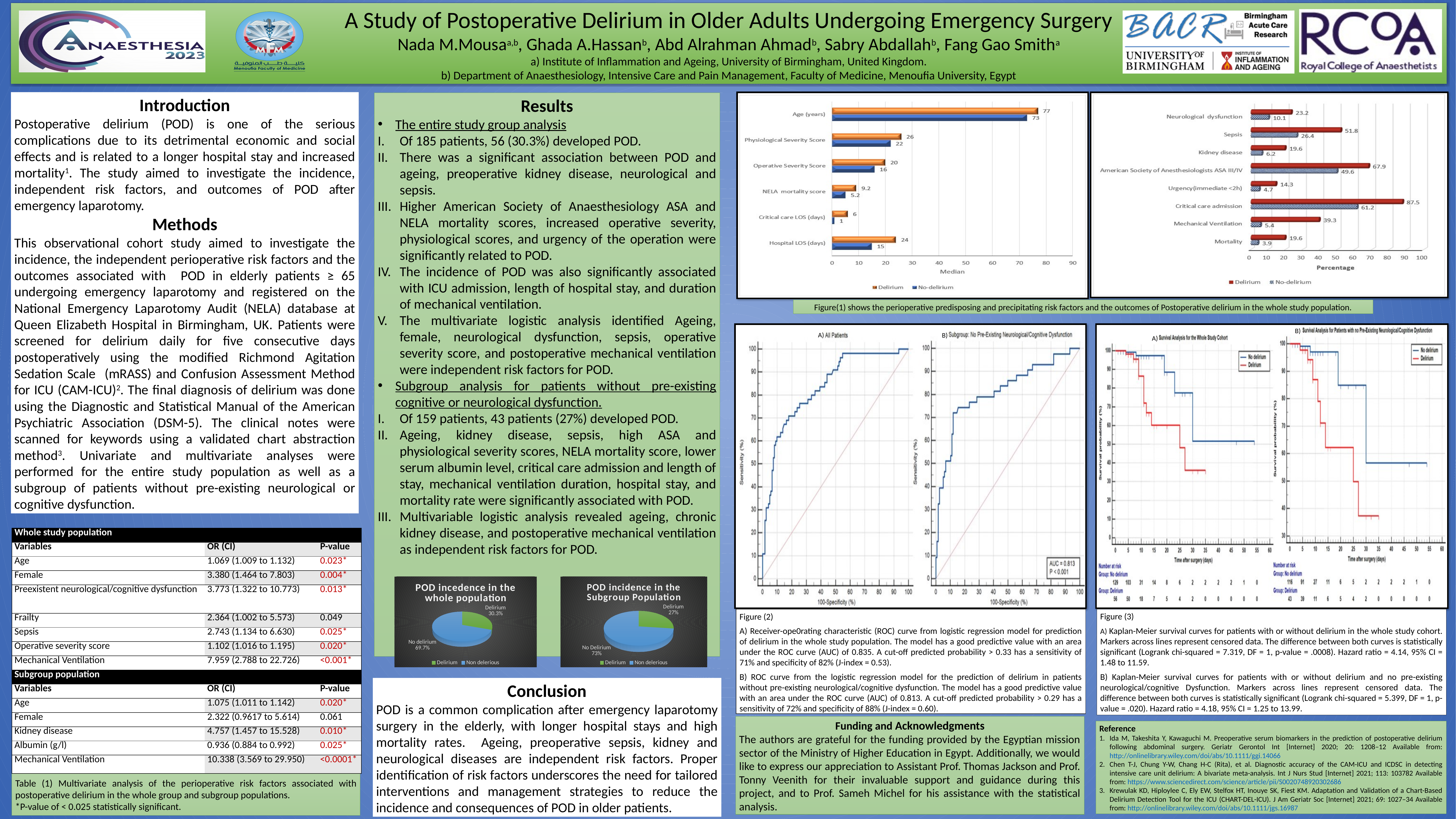
In the right bar chart of Figure 1 (Percentage), which category has the lowest No-delirium percentage? Mortality In the pie chart titled 'POD incidence in the Subgroup Population', what share of the pie is No Delirium? 73% In the left bar chart of Figure 1 (Median), what is the median Hospital LOS (days) for the No-delirium group? 15 In the pie chart titled 'POD incedence in the whole population', what share of the pie is Delirium? 30.3% In the right bar chart of Figure 1 (Percentage), which category has the highest Delirium percentage? Critical care admission In the left bar chart of Figure 1 (Median), what is the difference between the Delirium and No-delirium values for Critical care LOS (days)? 5 In the right bar chart of Figure 1 (Percentage), what is the Delirium percentage for Critical care admission? 87.5 In the right bar chart of Figure 1 (Percentage), what is the No-delirium percentage for Sepsis? 26.4 In the left bar chart of Figure 1 (Median), what is the median Age (years) for the Delirium group? 77 In the right bar chart of Figure 1 (Percentage), is the Delirium value for Mechanical Ventilation larger or smaller than the Delirium value for Kidney disease? larger In the left bar chart of Figure 1 (Median), how many categories are shown on the vertical axis? 6 In the right bar chart of Figure 1 (Percentage), how many series does the legend list? 2